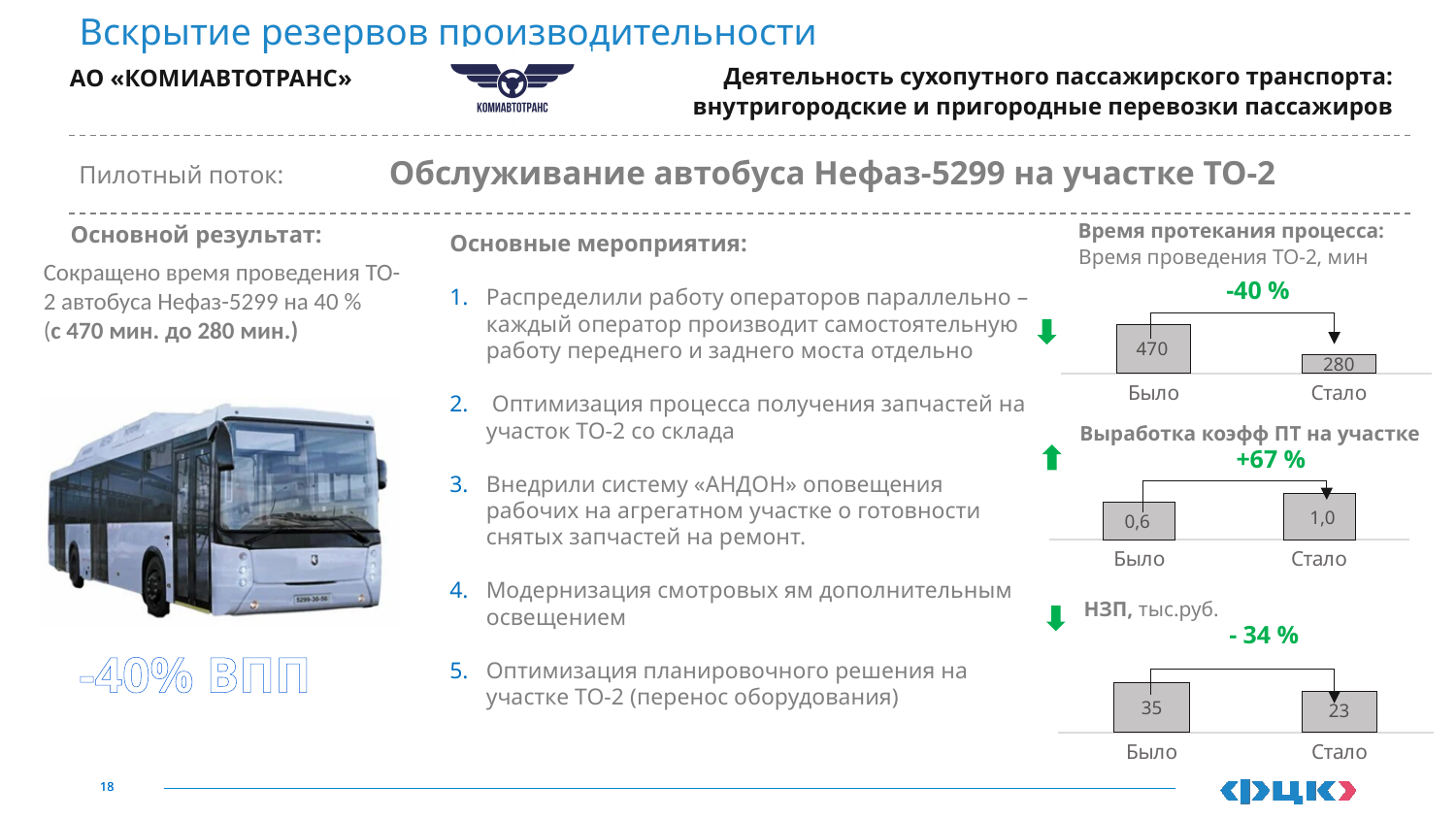
In the chart 'Время протекания процесса', what is the value for 'Стало'? 280 In the chart 'НЗП, тыс.руб.', what is the difference between 'Было' and 'Стало'? 12 In the chart 'Время протекания процесса', what percentage change is shown above the bars? -40 % In the chart 'Выработка коэфф ПТ на участке', what is the value for 'Стало'? 1,0 In the chart 'Выработка коэфф ПТ на участке', what is the value for 'Было'? 0,6 In the chart 'НЗП, тыс.руб.', what is the value for 'Стало'? 23 In the chart 'Выработка коэфф ПТ на участке', which bar is higher, 'Было' or 'Стало'? Стало What type of chart is used for 'Время протекания процесса'? Bar chart In the chart 'Время протекания процесса', what is the difference between 'Было' and 'Стало'? 190 In the chart 'Время протекания процесса', what is the value for 'Было'? 470 In the chart 'НЗП, тыс.руб.', which category has the lowest value? Стало In the chart 'НЗП, тыс.руб.', what is the value for 'Было'? 35